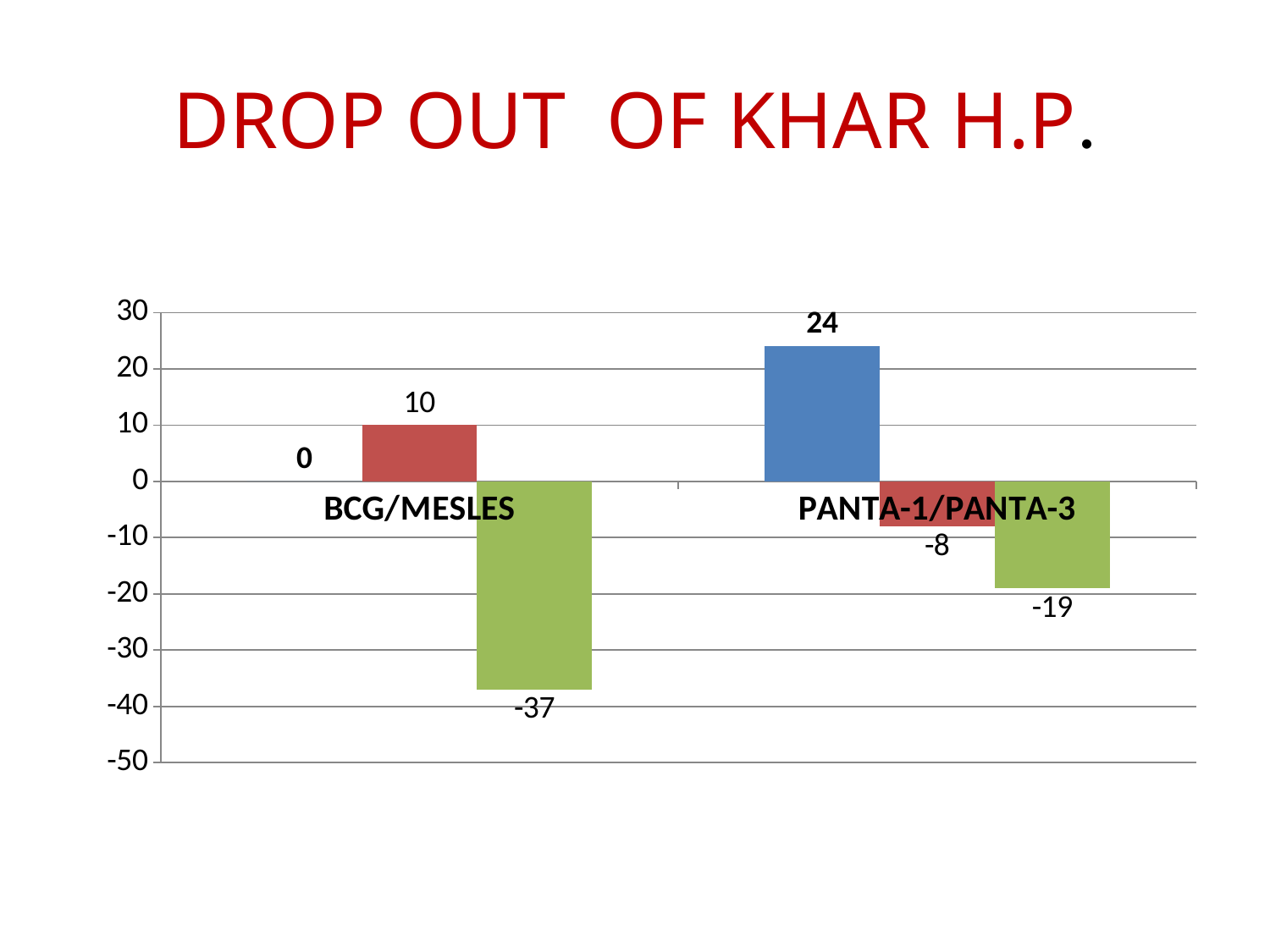
What is the value of the red bar for PANTA-1/PANTA-3? -8 What type of chart is shown on the slide? Bar chart Which is larger, the red bar for BCG/MESLES or the red bar for PANTA-1/PANTA-3? BCG/MESLES What is the value of the green bar for BCG/MESLES? -37 What is the difference between the green bar values for BCG/MESLES and PANTA-1/PANTA-3? 18 How many categories are shown on the x axis? 2 Which bar has the lowest value on the chart? The green bar for BCG/MESLES (-37) Which bar has the highest value on the chart? The blue bar for PANTA-1/PANTA-3 (24) What is the value of the green bar for PANTA-1/PANTA-3? -19 What is the value of the red bar for BCG/MESLES? 10 What is the value of the blue bar for BCG/MESLES? 0 What is the value of the blue bar for PANTA-1/PANTA-3? 24